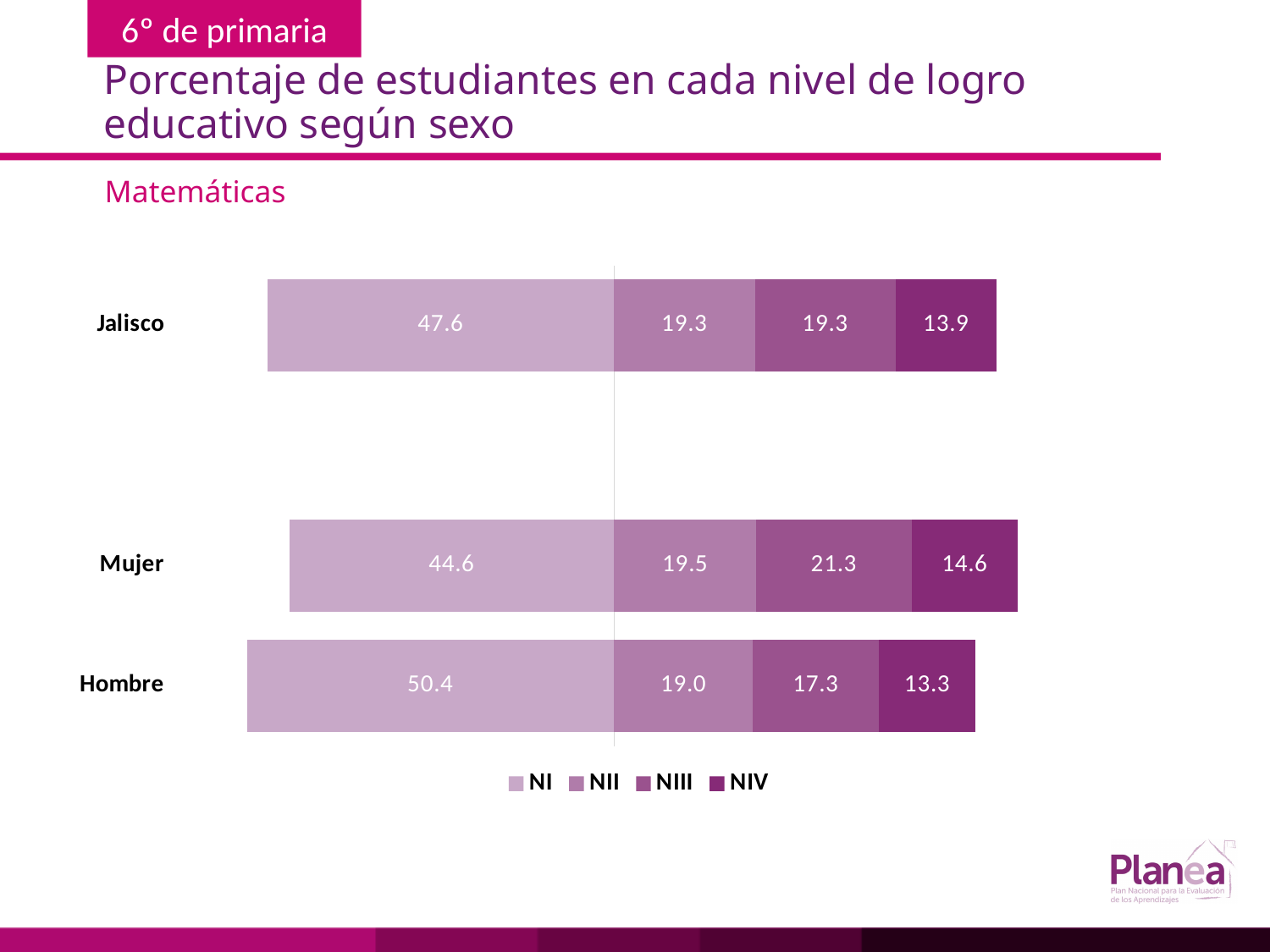
What is the NIII value for Mujer? 21.3 What is the NIV value for Jalisco? 13.9 What is the NI value for Hombre? 50.4 Which category has the highest NI value? Hombre What is the difference between the NI values for Hombre and Mujer? 5.8 How many series does the legend list? 4 Which category has the lowest NIV value? Hombre What kind of chart is shown on the slide? Stacked bar chart Which is larger, the NIII value for Mujer or the NIII value for Jalisco? Mujer What is the total of the stacked bar for Mujer? 100.0 What is the NII value for Hombre? 19.0 How many categories are shown on the chart? 3